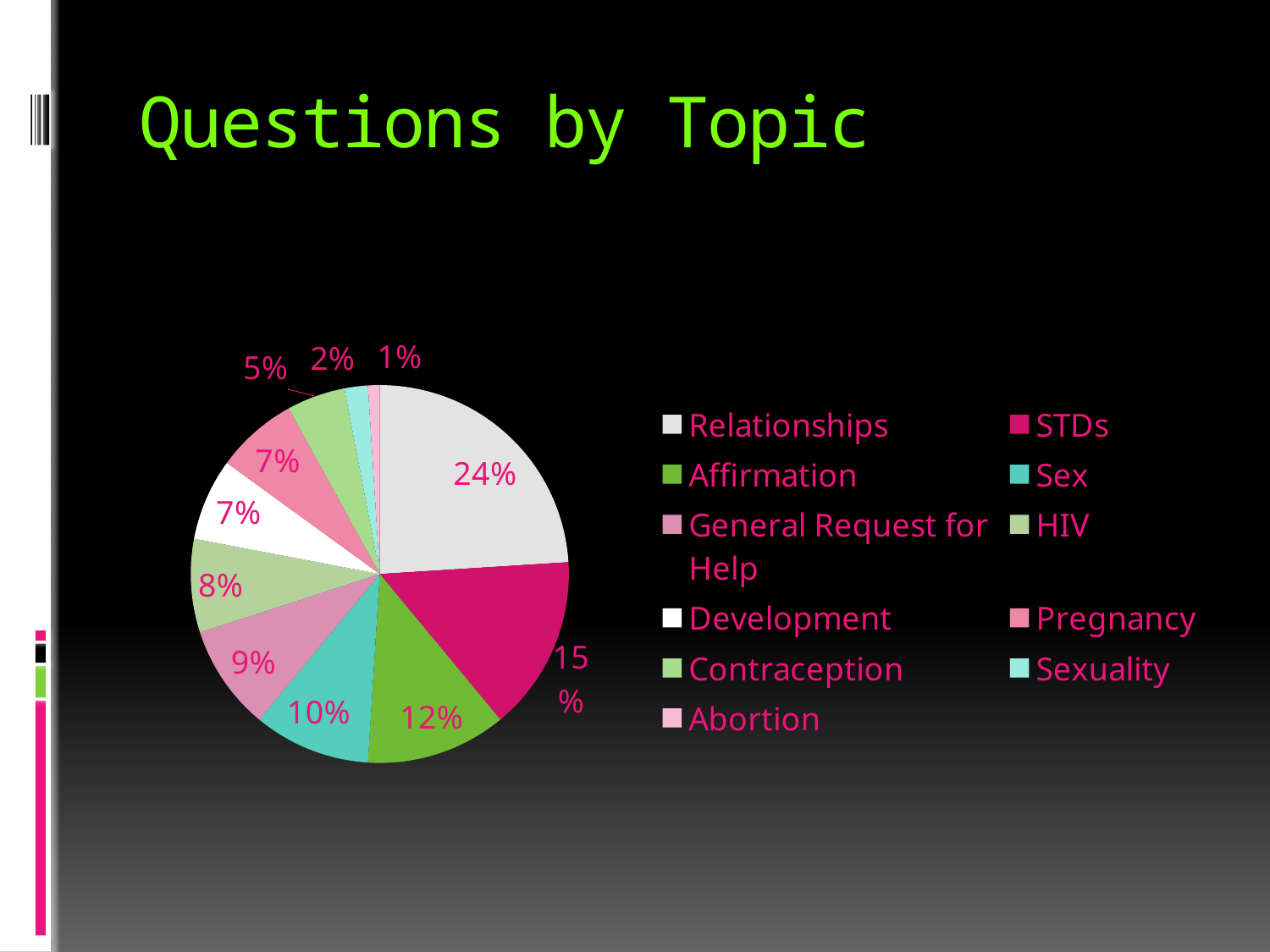
Which topic has the largest share of questions? Relationships How many topics are shown in the pie chart? 11 What type of chart is shown on the slide? pie chart What share of questions is about Relationships? 24% What share of questions is about STDs? 15% Which topic has the smallest share of questions? Abortion What share of questions is about Sex? 10% What share of questions is about Abortion? 1% What is the difference in percentage points between Relationships and STDs? 9 Which has a larger share, Affirmation or HIV? Affirmation What share of questions is about Contraception? 5% What is the title of the chart? Questions by Topic